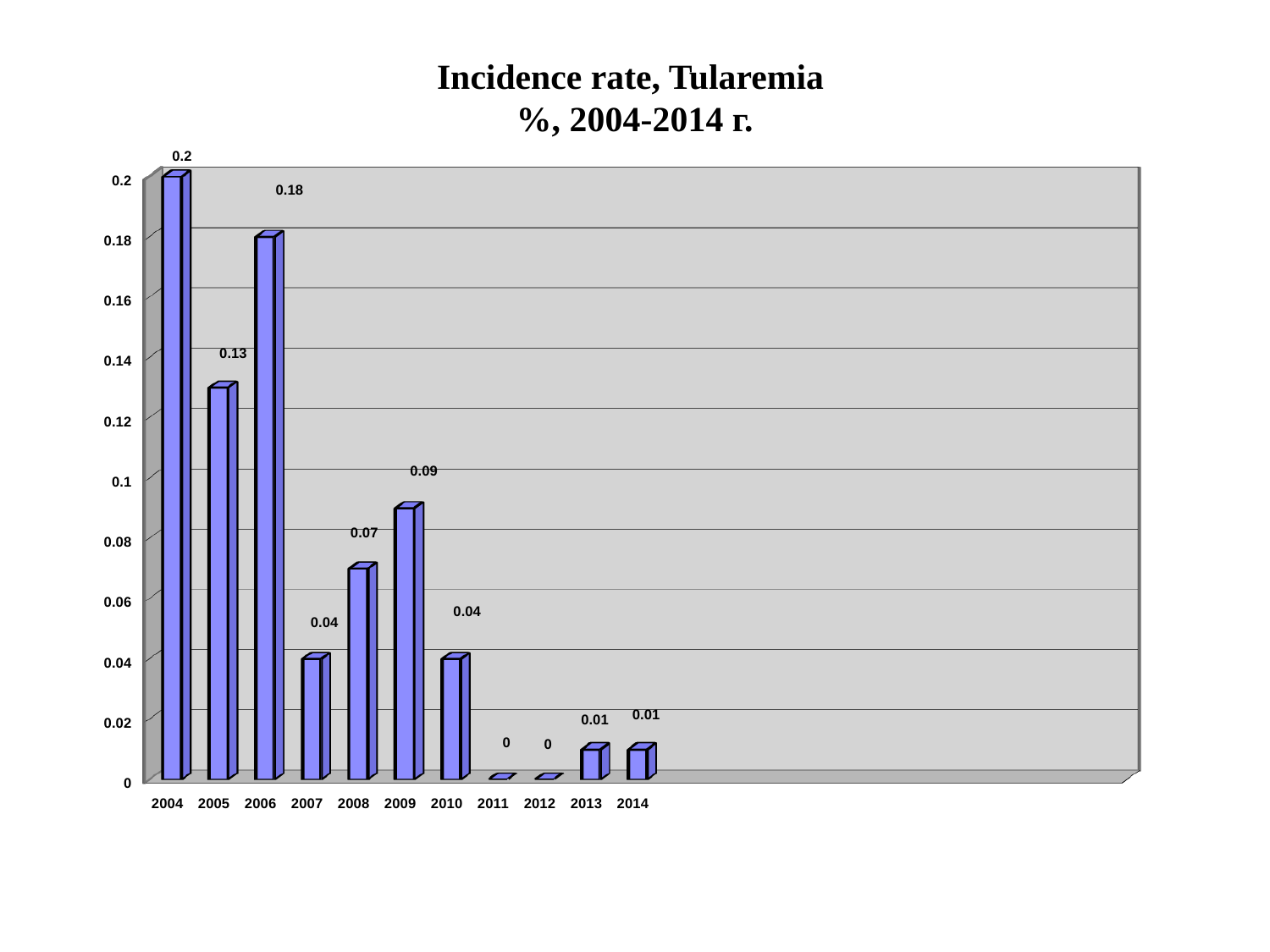
What is the incidence rate of tularemia in 2013? 0.01 What kind of chart is shown on the slide? bar chart What is the title of the chart? Incidence rate, Tularemia %, 2004-2014 г. What is the incidence rate of tularemia in 2009? 0.09 Do the incidence rates generally rise or fall from 2004 to 2014? fall Which year has the highest incidence rate of tularemia? 2004 What is the difference between the incidence rates in 2004 and 2006? 0.02 What is the incidence rate of tularemia in 2004? 0.2 How many years are shown on the x axis? 11 Is the incidence rate for 2006 greater or less than 0.1? greater Which year has a higher incidence rate, 2005 or 2009? 2005 What is the difference between the incidence rates in 2005 and 2008? 0.06